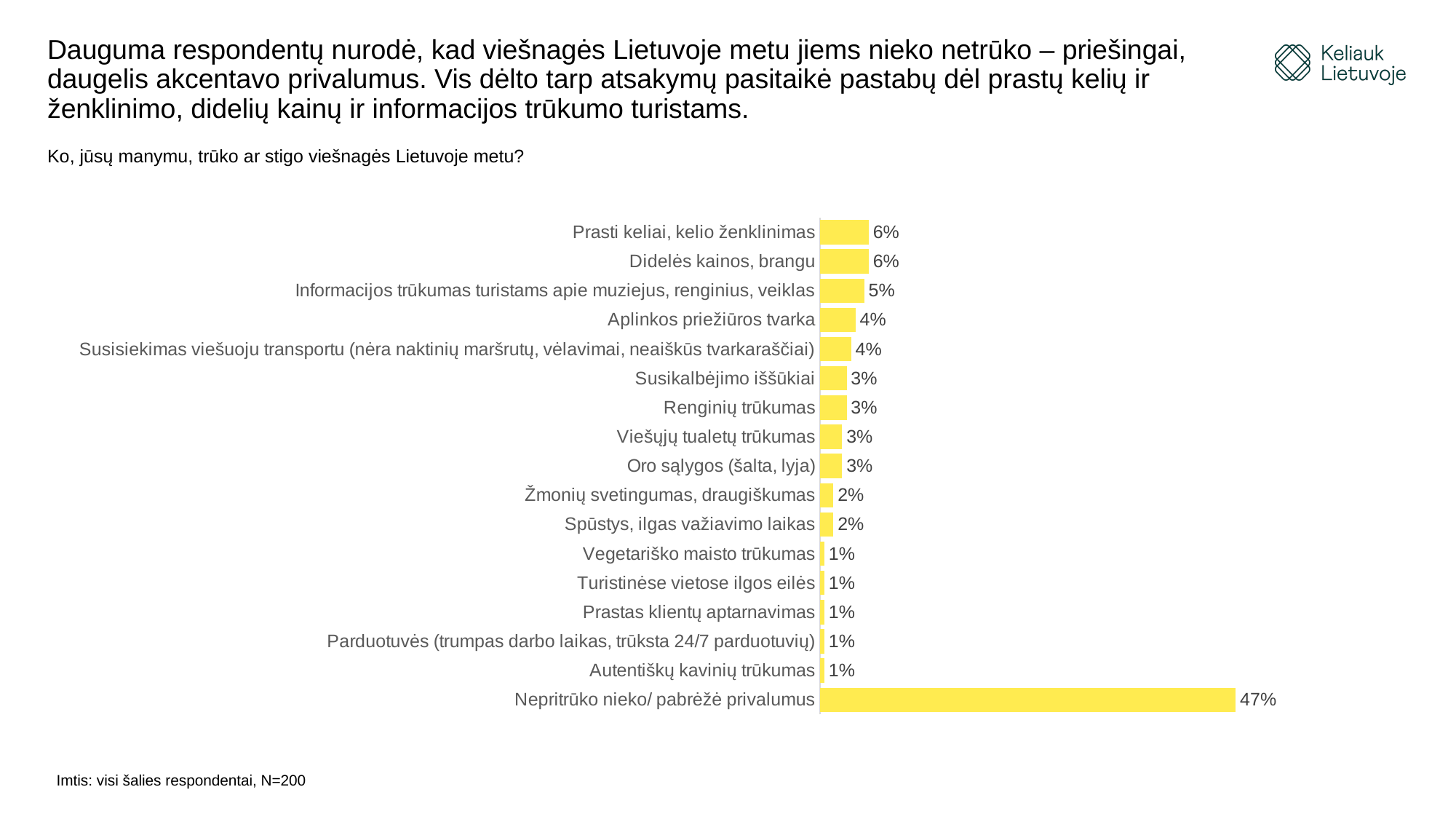
Which is larger, the value for "Prasti keliai, kelio ženklinimas" or the value for "Žmonių svetingumas, draugiškumas"? Prasti keliai, kelio ženklinimas Which category has the highest value? Nepritrūko nieko/ pabrėžė privalumus How many categories are shown in the chart? 17 What is the value for "Autentiškų kavinių trūkumas"? 1% What is the value for "Nepritrūko nieko/ pabrėžė privalumus"? 47% What is the value for "Spūstys, ilgas važiavimo laikas"? 2% What is the difference between the values for "Nepritrūko nieko/ pabrėžė privalumus" and "Prasti keliai, kelio ženklinimas"? 41% What kind of chart is shown on the slide? Bar chart What is the difference between the values for "Didelės kainos, brangu" and "Susikalbėjimo iššūkiai"? 3% What colour are the bars in the chart? Yellow What is the value for "Informacijos trūkumas turistams apie muziejus, renginius, veiklas"? 5% What is the value for "Aplinkos priežiūros tvarka"? 4%